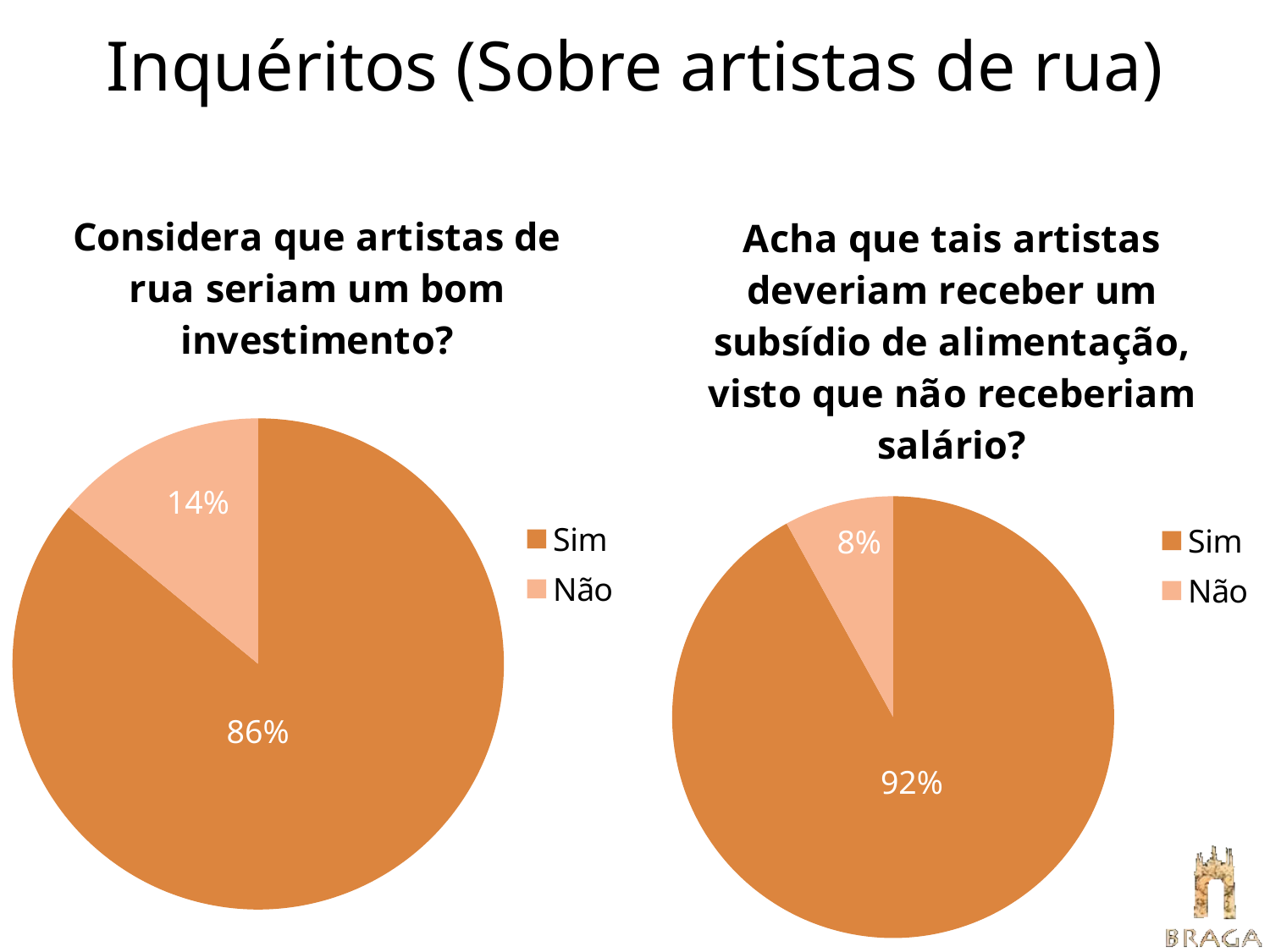
In the left pie chart, what is the difference between the Sim and Não shares? 72% In the left pie chart, which response has the largest share? Sim How many categories does the legend of the right pie chart list? 2 In the right pie chart, what is the difference between the Sim and Não shares? 84% In the right pie chart ("Acha que tais artistas deveriam receber um subsídio de alimentação..."), what percentage answered Sim? 92% Which is larger: the Não share in the left pie chart or the Não share in the right pie chart? The left pie chart (14%) In the right pie chart ("Acha que tais artistas deveriam receber um subsídio de alimentação..."), what percentage answered Não? 8% In the left pie chart ("Considera que artistas de rua seriam um bom investimento?"), what percentage answered Sim? 86% In the left pie chart ("Considera que artistas de rua seriam um bom investimento?"), what percentage answered Não? 14% What type of chart is used on the left of the slide? Pie chart What is the title of the slide? Inquéritos (Sobre artistas de rua) In the right pie chart, which response has the smallest share? Não